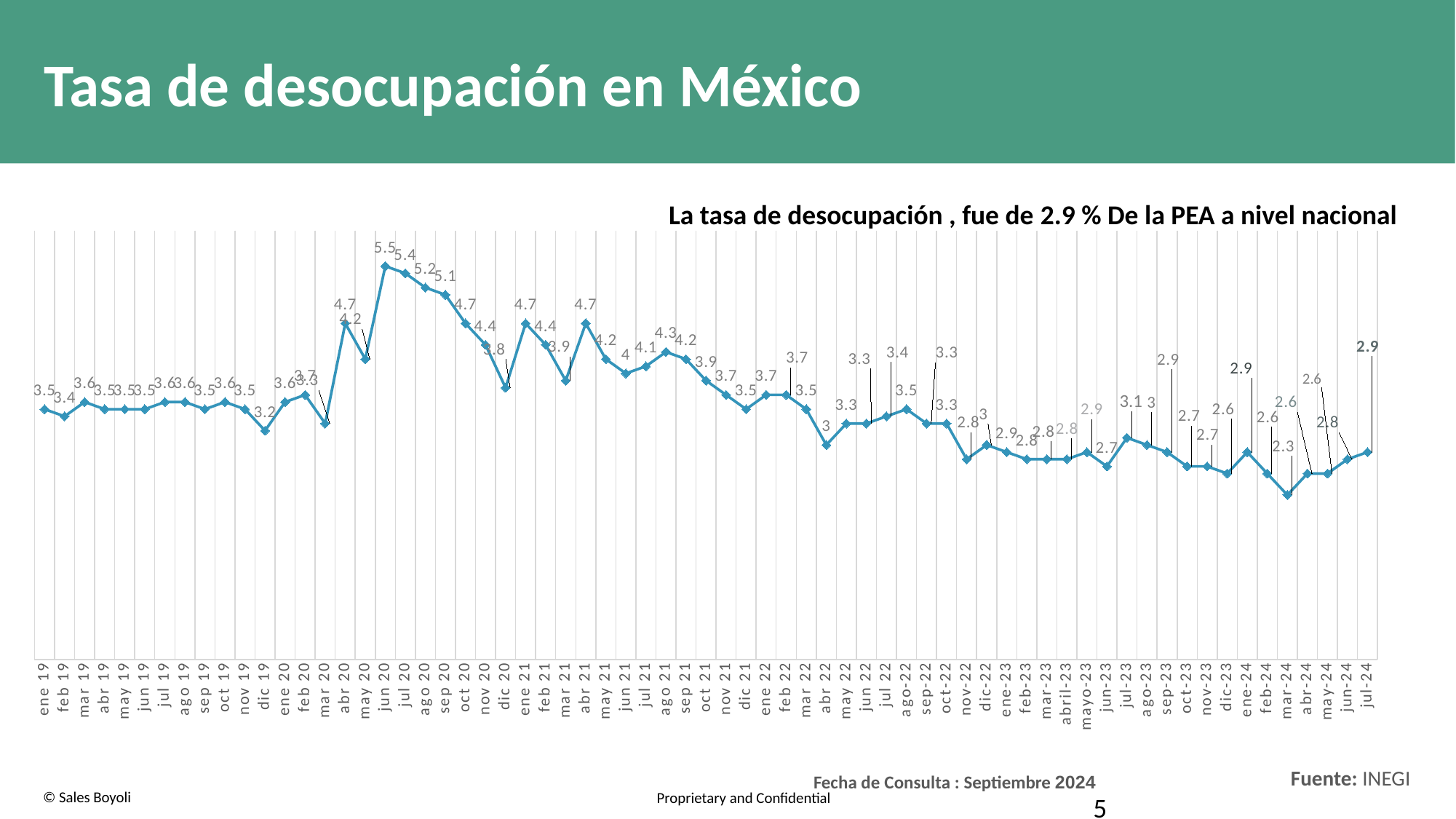
In which month does the unemployment rate reach its highest value? jun 20 What is the value for jul-24? 2.9 What kind of chart is shown on the slide? line chart What is the difference between the value for jun 20 and the value for jul-24? 2.6 What is the value for abr 22? 3 What is the title of the slide? Tasa de desocupación en México Do the values rise or fall from jun 20 to sep 20? fall Which is larger, the value for abr 20 or the value for may 20? abr 20 In which month is the unemployment rate lowest? mar-24 What is the highest value plotted on the chart? 5.5 What is the value for dic 19? 3.2 What is the value for mar-24? 2.3